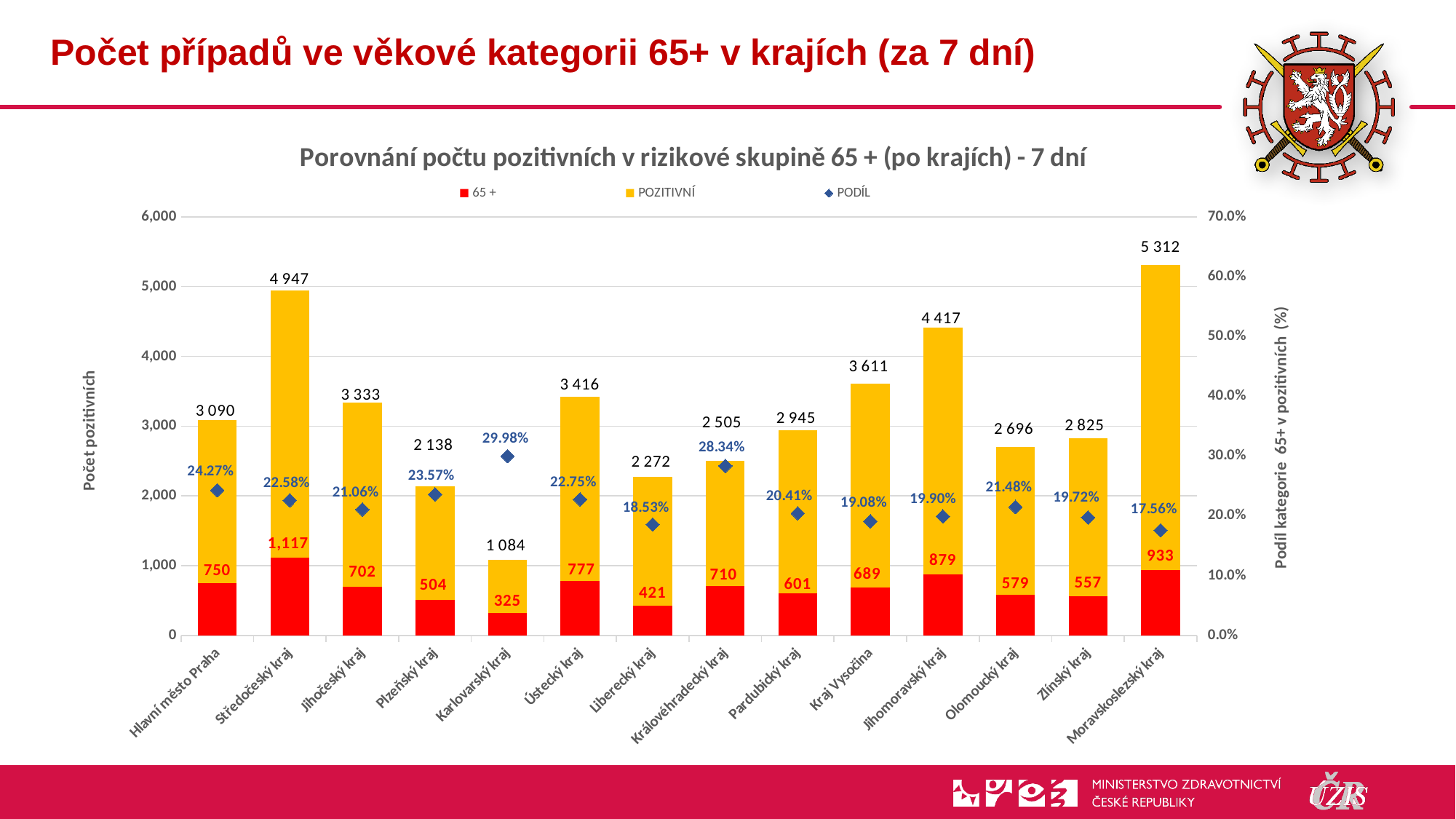
What is the title of the chart? Porovnání počtu pozitivních v rizikové skupině 65 + (po krajích) - 7 dní What kind of chart is this? Bar chart with a line/marker series Which region has the lowest 65 + value? Karlovarský kraj How many regions are shown on the x axis? 14 Which region has the lowest PODÍL value? Moravskoslezský kraj Which region has the highest POZITIVNÍ value? Moravskoslezský kraj What is the difference between the POZITIVNÍ values for Středočeský kraj and Jihomoravský kraj? 530 How many series does the legend list? 3 What is the PODÍL value for Karlovarský kraj? 29.98% What is the POZITIVNÍ value for Moravskoslezský kraj? 5 312 What is the 65 + value for Středočeský kraj? 1,117 Which is larger, the 65 + value for Ústecký kraj or for Hlavní město Praha? Ústecký kraj